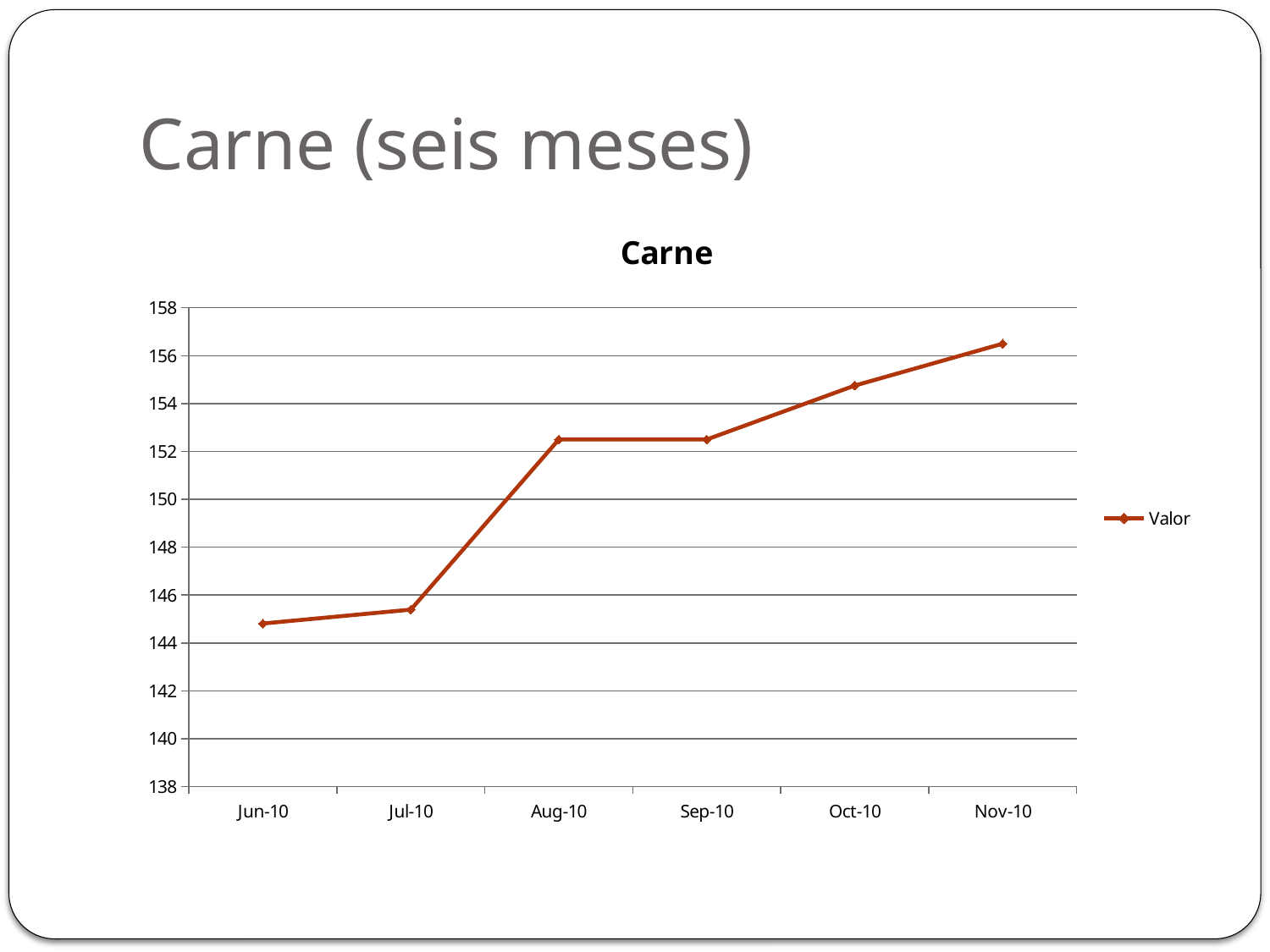
What kind of chart is shown on the slide? line chart Which is larger, the value for Nov-10 or the value for Aug-10? Nov-10 Which is larger, the value for Oct-10 or the value for Jul-10? Oct-10 How many data points are plotted on the Carne chart? 6 What is the title of the chart? Carne What is the name of the series shown in the legend? Valor Is the value for Aug-10 greater or less than 150? greater Is the value for Sep-10 greater or less than 154? less Do the values generally rise or fall from Jun-10 to Nov-10? rise How many series does the legend of the Carne chart list? 1 Which month has the highest value on the Carne chart? Nov-10 Is the value for Jun-10 greater or less than 146? less